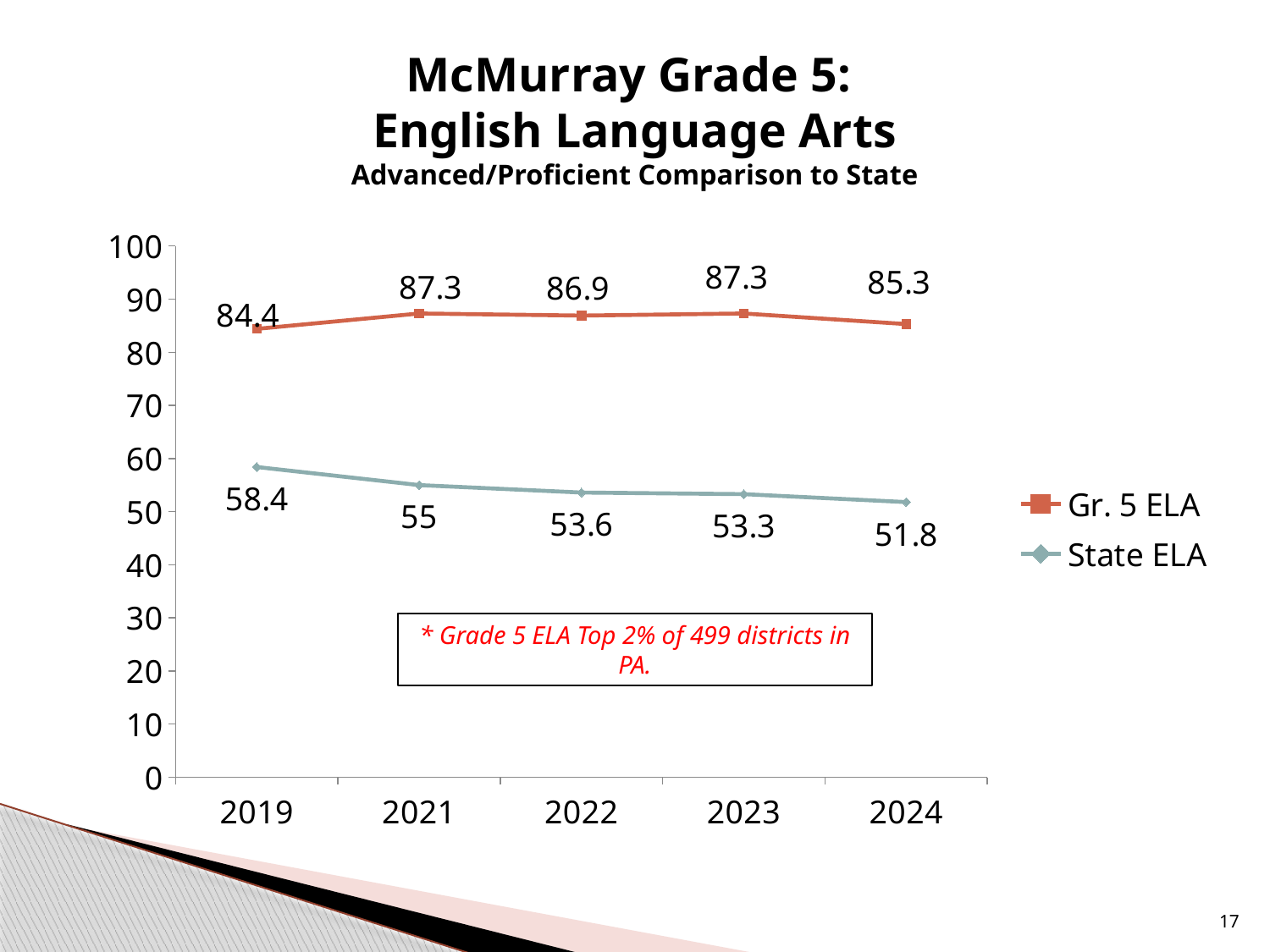
What is the Gr. 5 ELA value for 2019? 84.4 What kind of chart is shown on the slide? line chart In which year is the State ELA value highest? 2019 In which year is the Gr. 5 ELA value lowest? 2019 What is the Gr. 5 ELA value for 2021? 87.3 Is the State ELA value for 2022 greater or less than 60? less How many years are shown on the x axis? 5 Which is larger, the State ELA value in 2019 or in 2023? 2019 What is the State ELA value for 2024? 51.8 How many series does the legend list? 2 What is the difference between the Gr. 5 ELA and State ELA values in 2024? 33.5 Does the State ELA line rise or fall from 2019 to 2024? fall